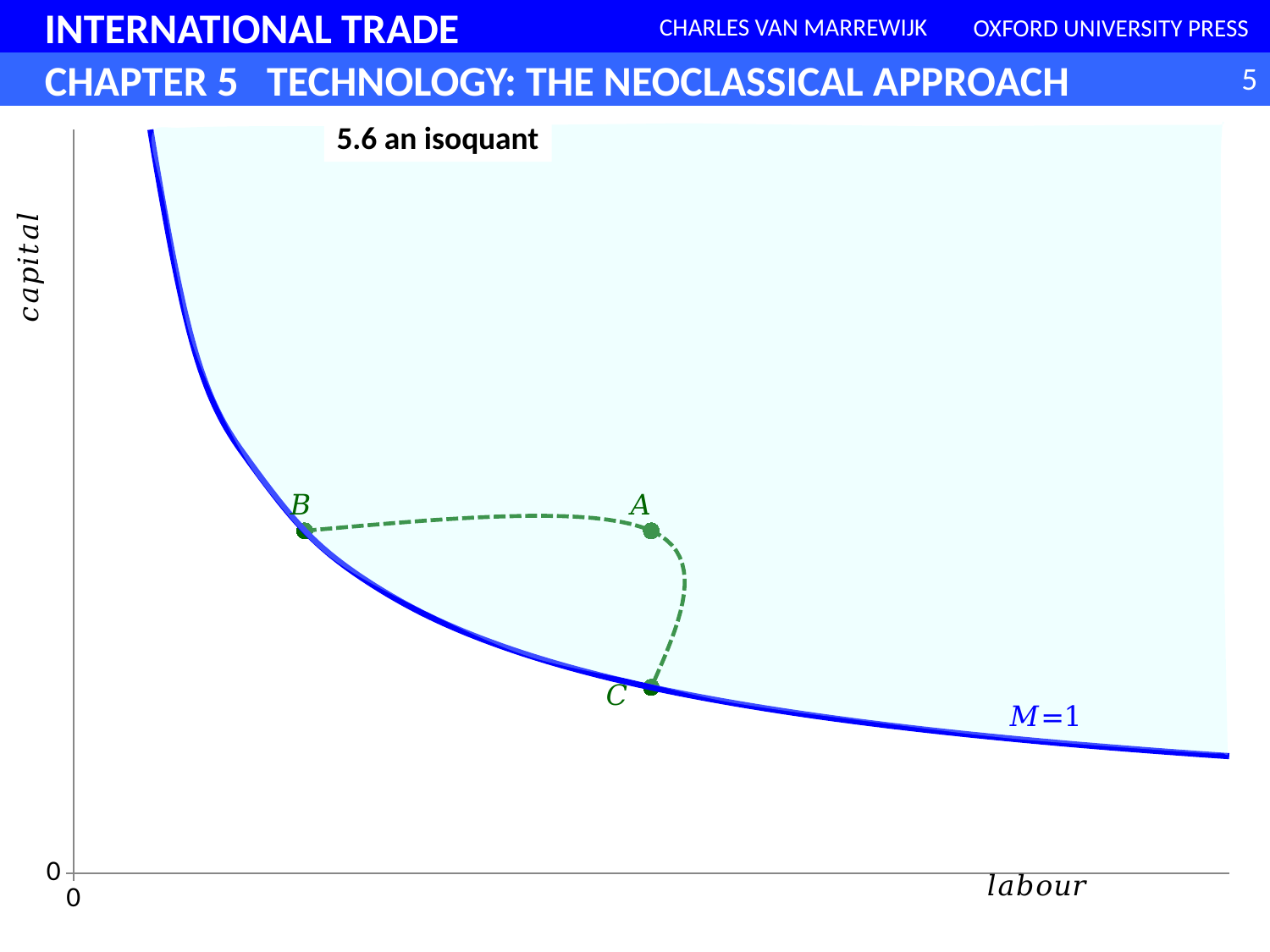
Which point has more capital, A or C? A What label is attached to the solid blue curve in the chart? M=1 Does the isoquant curve rise or fall as labour increases along the x axis? fall Which labelled points lie on the solid blue isoquant curve? B and C Which point has more labour, B or C? C What value is printed at the origin of the axes? 0 Which point has more labour, A or B? A What is the title of the chart on the slide? 5.6 an isoquant How many labelled points are marked on the chart? 3